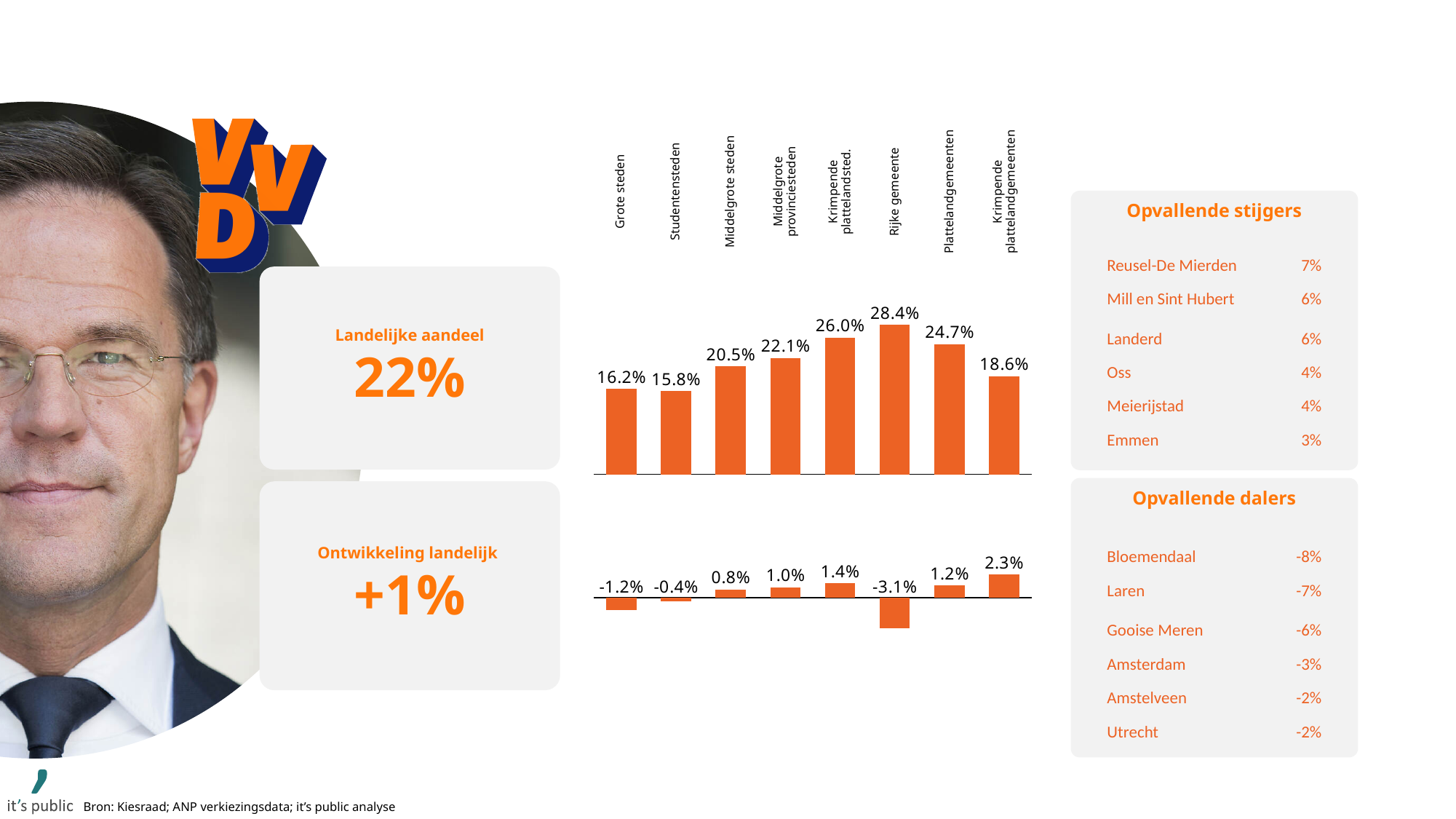
What type of chart is the lower chart? bar chart In the upper chart, which category has the lowest value? Studentensteden In the lower chart, which category has the highest value? Krimpende plattelandgemeenten In the upper chart, which category has the highest value? Rijke gemeente In the lower chart, what is the value for Rijke gemeente? -3.1% In the lower chart, what is the difference between Krimpende plattelandgemeenten and Plattelandgemeenten? 1.1% How many categories are shown in the upper chart? 8 In the upper chart, what is the difference between Krimpende plattelandsted. and Grote steden? 9.8% In the upper chart, which is larger: Plattelandgemeenten or Middelgrote provinciesteden? Plattelandgemeenten In the upper chart, what is the value for Studentensteden? 15.8% In the lower chart, which category has the lowest value? Rijke gemeente In the upper chart, what is the value for Rijke gemeente? 28.4%